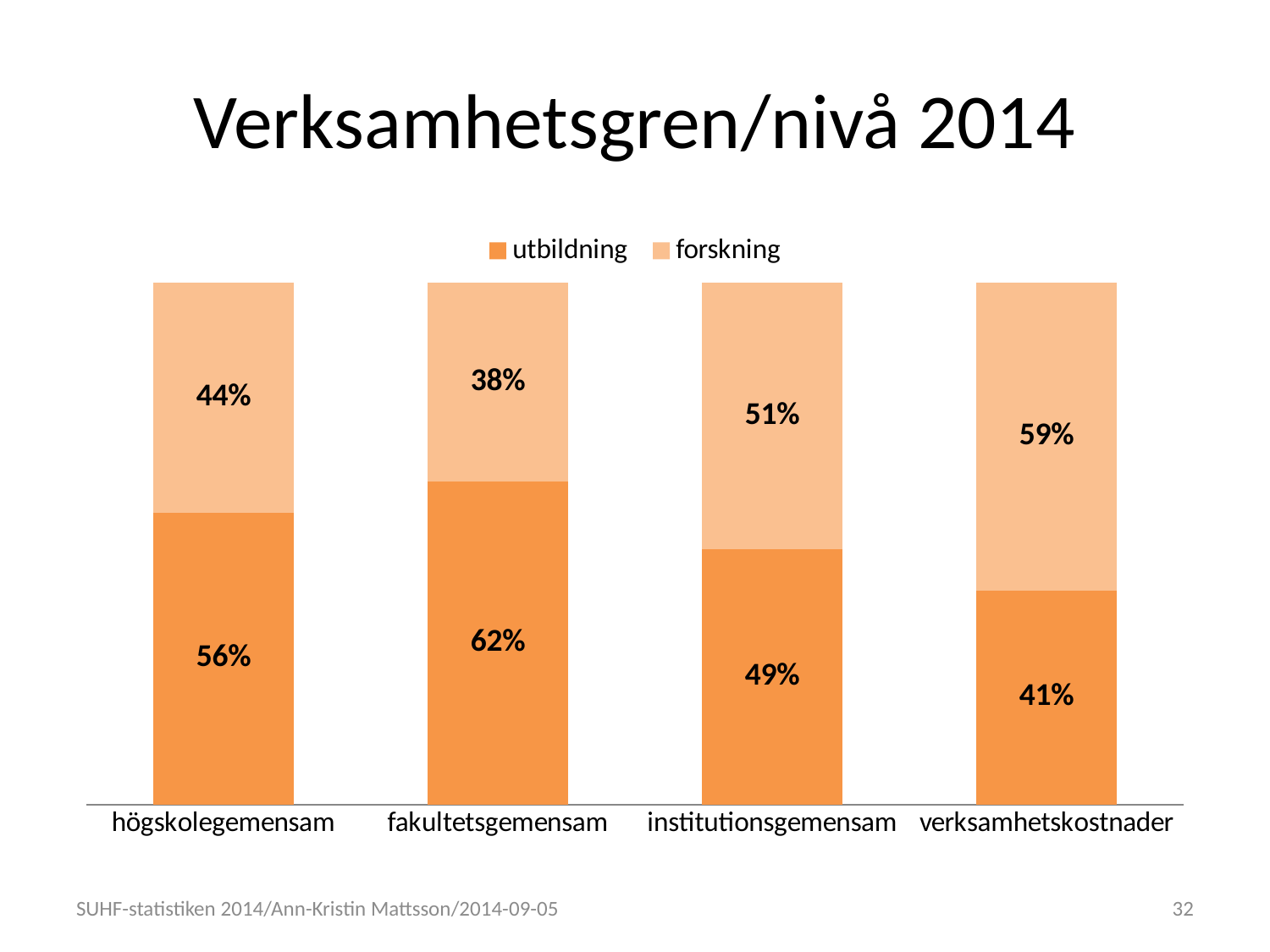
Which category has the highest utbildning share? fakultetsgemensam How many categories are shown on the x axis? 4 What is the utbildning share for institutionsgemensam? 49% What is the forskning share for fakultetsgemensam? 38% What is the title of the chart? Verksamhetsgren/nivå 2014 What is the utbildning share for högskolegemensam? 56% What kind of chart is shown on the slide? stacked bar chart How many series does the legend list? 2 What is the forskning share for verksamhetskostnader? 59% What is the difference between the utbildning shares of fakultetsgemensam and verksamhetskostnader? 21% Which category has the lowest forskning share? fakultetsgemensam Is the forskning share larger for institutionsgemensam or for högskolegemensam? institutionsgemensam